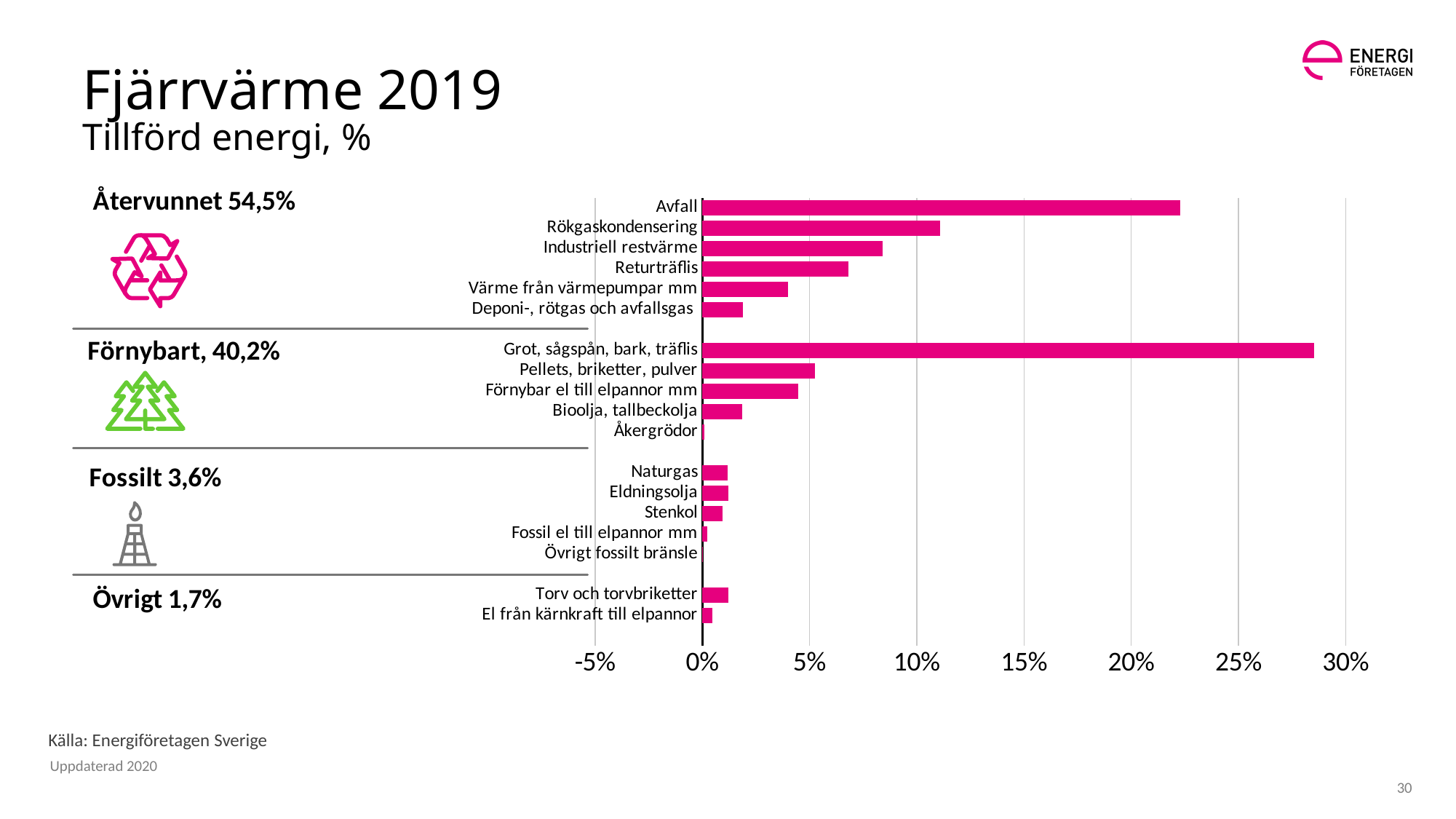
Is the value for Returträflis greater or less than 5%? greater Is the value for Naturgas greater or less than 5%? less How many categories are plotted in the chart? 18 Which category has the longest bar in the chart? Grot, sågspån, bark, träflis Is the value for Industriell restvärme greater or less than 10%? less What kind of chart is shown on the slide? bar chart Which is larger, the value for Industriell restvärme or the value for Returträflis? Industriell restvärme Which is larger, the value for Avfall or the value for Rökgaskondensering? Avfall What is the title of the slide containing the chart? Fjärrvärme 2019